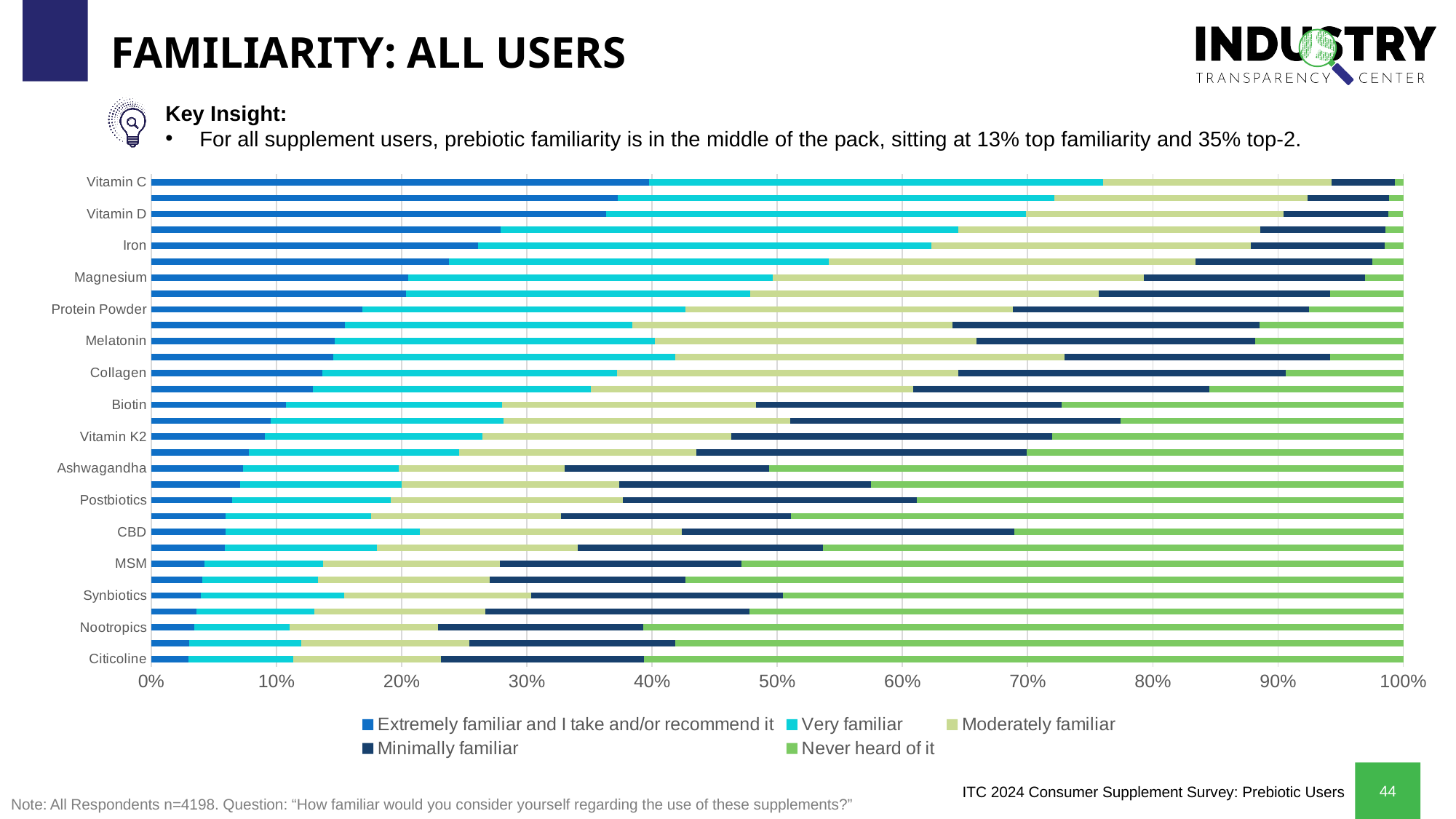
Is the 'Extremely familiar and I take and/or recommend it' value for Ashwagandha greater or less than 10%? less Is the 'Extremely familiar and I take and/or recommend it' value for Vitamin C greater or less than 30%? greater What is the title of the slide containing the chart? FAMILIARITY: ALL USERS Is the 'Extremely familiar and I take and/or recommend it' value for Iron greater or less than 20%? greater Which has the larger 'Extremely familiar and I take and/or recommend it' segment, Vitamin C or Citicoline? Vitamin C Which has the larger 'Never heard of it' segment, Citicoline or Vitamin C? Citicoline What kind of chart is shown on the slide? Stacked bar chart Which labeled supplement has the largest 'Extremely familiar and I take and/or recommend it' segment? Vitamin C Moving from the top bar (Vitamin C) to the bottom bar (Citicoline), does the 'Extremely familiar and I take and/or recommend it' segment generally increase or decrease? decrease How many series does the legend list? 5